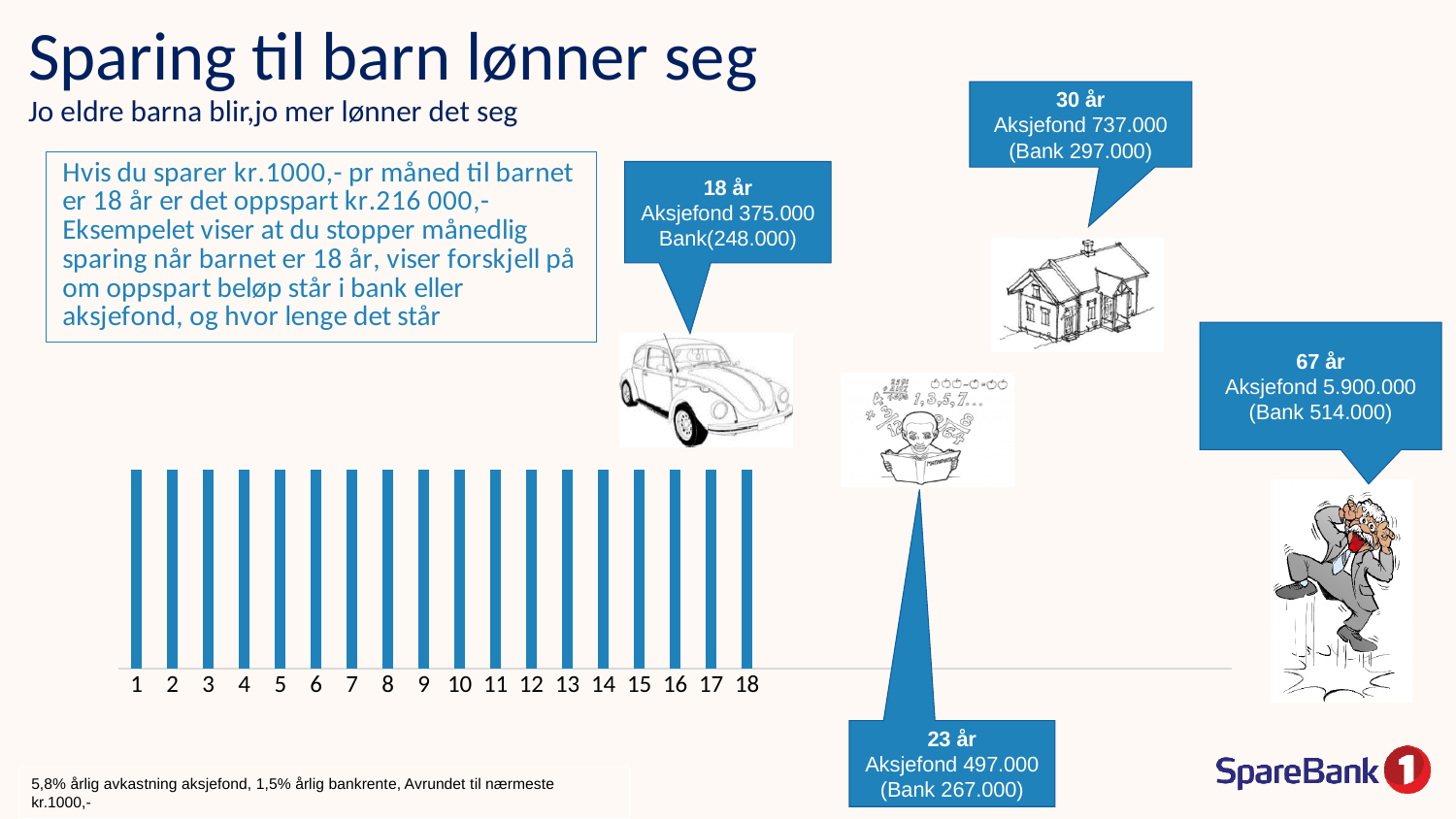
What is the label of the last category on the x axis? 18 How many bars does the chart have? 18 What colour are the bars in the chart? blue Do the bar heights rise, fall or stay the same from category 1 to category 18? stay the same What is the label of the first category on the x axis? 1 What kind of chart is shown on the slide? bar chart